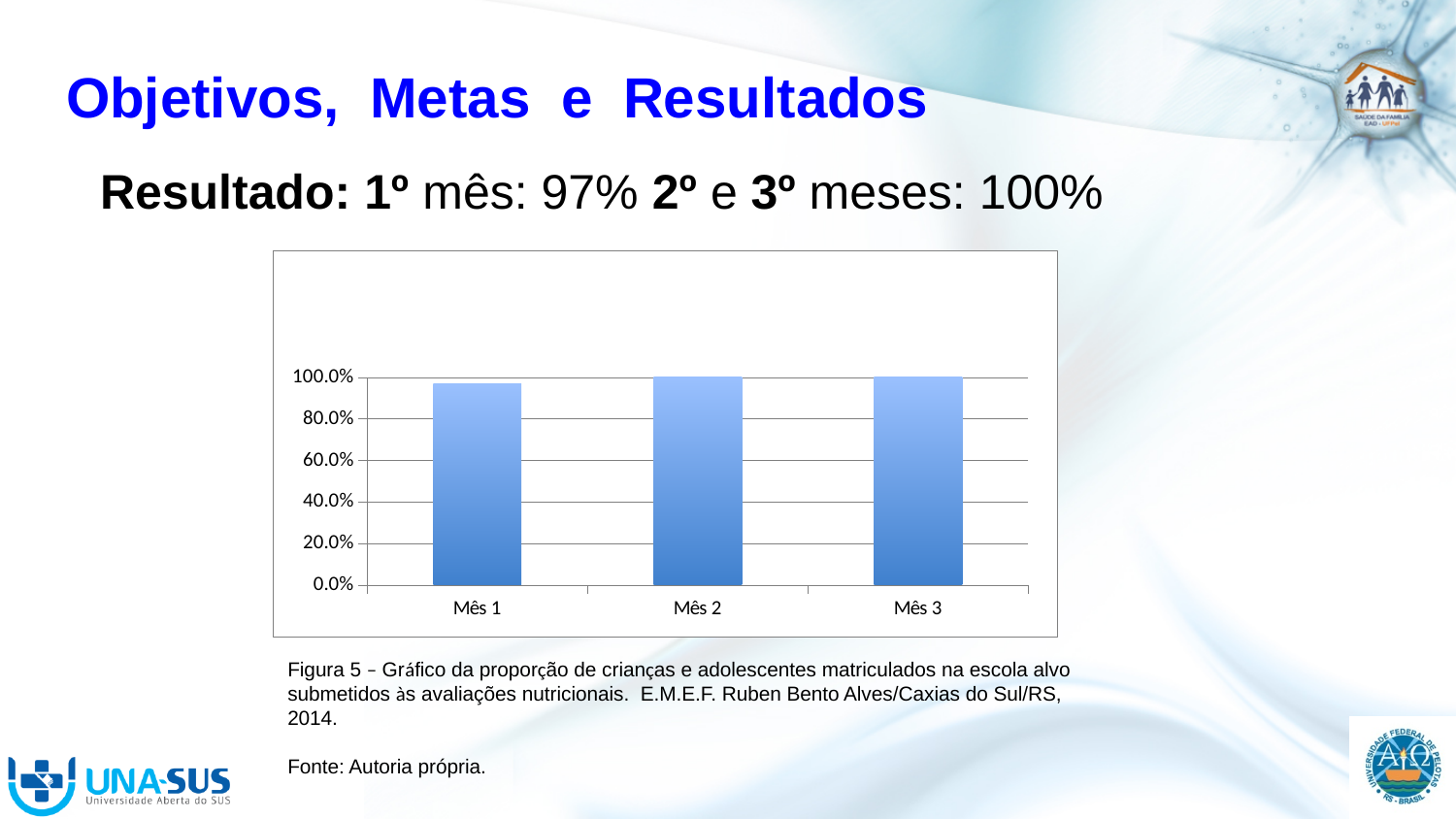
What is the label of the first category on the x axis? Mês 1 What is the highest tick value shown on the y axis of the chart? 100.0% Is the value for Mês 1 greater or less than 80.0%? greater What is the value for Mês 2 in the chart? 100.0% What is the value for Mês 3 in the chart? 100.0% According to the slide, what was the result for the 1º mês? 97% How many months (categories) are shown on the x axis of the chart? 3 Which month has the lowest value in the chart? Mês 1 What is the difference between the result for the 2º mês and the 1º mês as stated on the slide? 3% Which is larger, the value for Mês 1 or the value for Mês 2? Mês 2 Do the values rise or fall from Mês 1 to Mês 2? rise What kind of chart is shown on the slide? bar chart